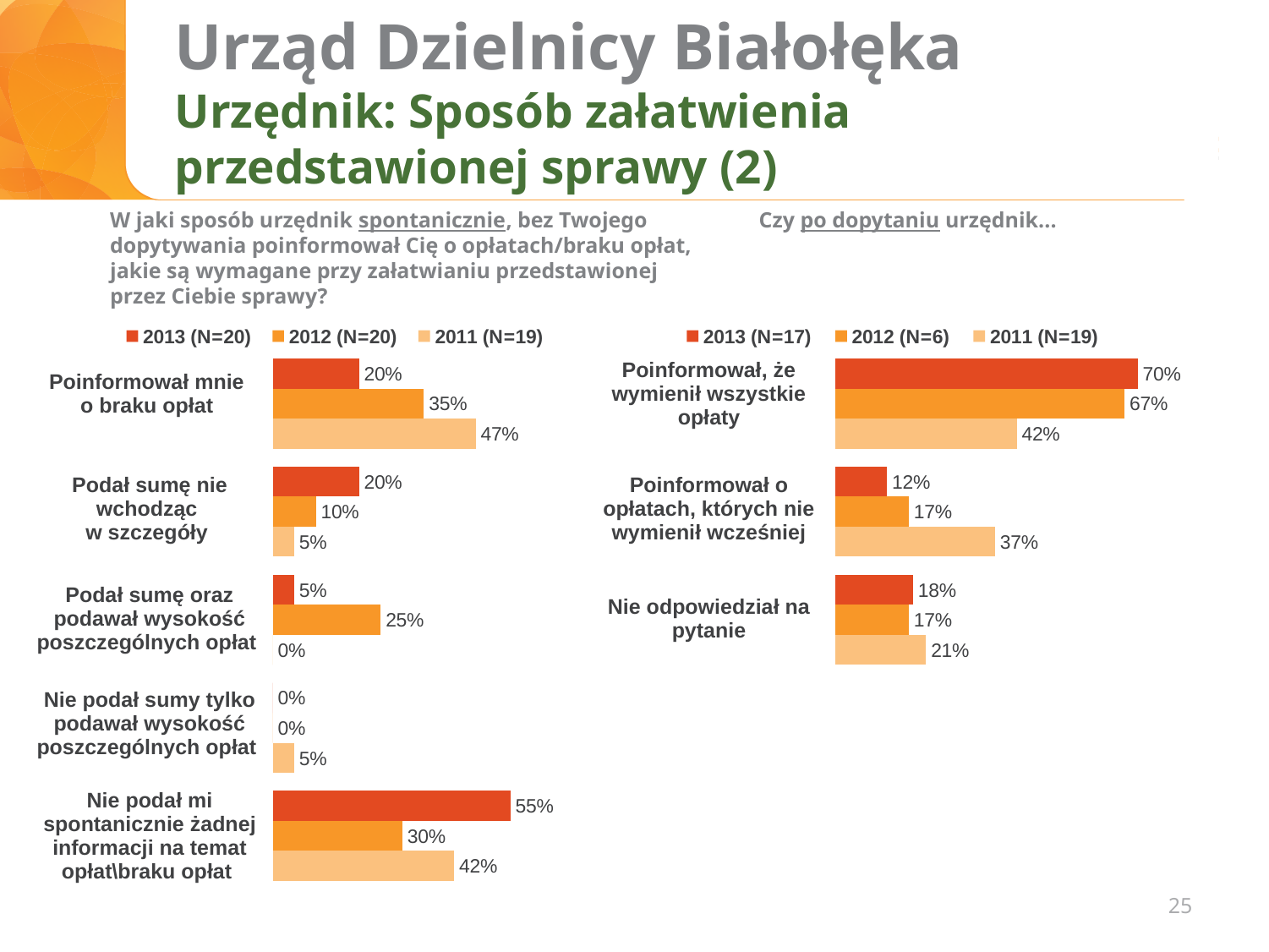
In the right chart, what is the 2013 value for 'Poinformował, że wymienił wszystkie opłaty'? 70% In the right chart, what is the 2011 value for 'Poinformował o opłatach, których nie wymienił wcześniej'? 37% How many categories does the left chart show? 5 In the left chart, which is larger for 'Podał sumę oraz podawał wysokość poszczególnych opłat': the 2013 value or the 2012 value? 2012 In the left chart, what is the 2013 value for 'Nie podał mi spontanicznie żadnej informacji na temat opłat\braku opłat'? 55% In the left chart, what is the 2011 value for 'Poinformował mnie o braku opłat'? 47% In the right chart, what is the difference between the 2013 and 2011 values for 'Poinformował, że wymienił wszystkie opłaty'? 28 percentage points How many series does the legend of the right chart list? 3 What type of chart is the right chart? Bar chart In the left chart, what is the difference between the 2013 and 2012 values for 'Nie podał mi spontanicznie żadnej informacji na temat opłat\braku opłat'? 25 percentage points In the left chart, which category has the highest 2013 value? Nie podał mi spontanicznie żadnej informacji na temat opłat\braku opłat In the right chart, which category has the lowest 2013 value? Poinformował o opłatach, których nie wymienił wcześniej